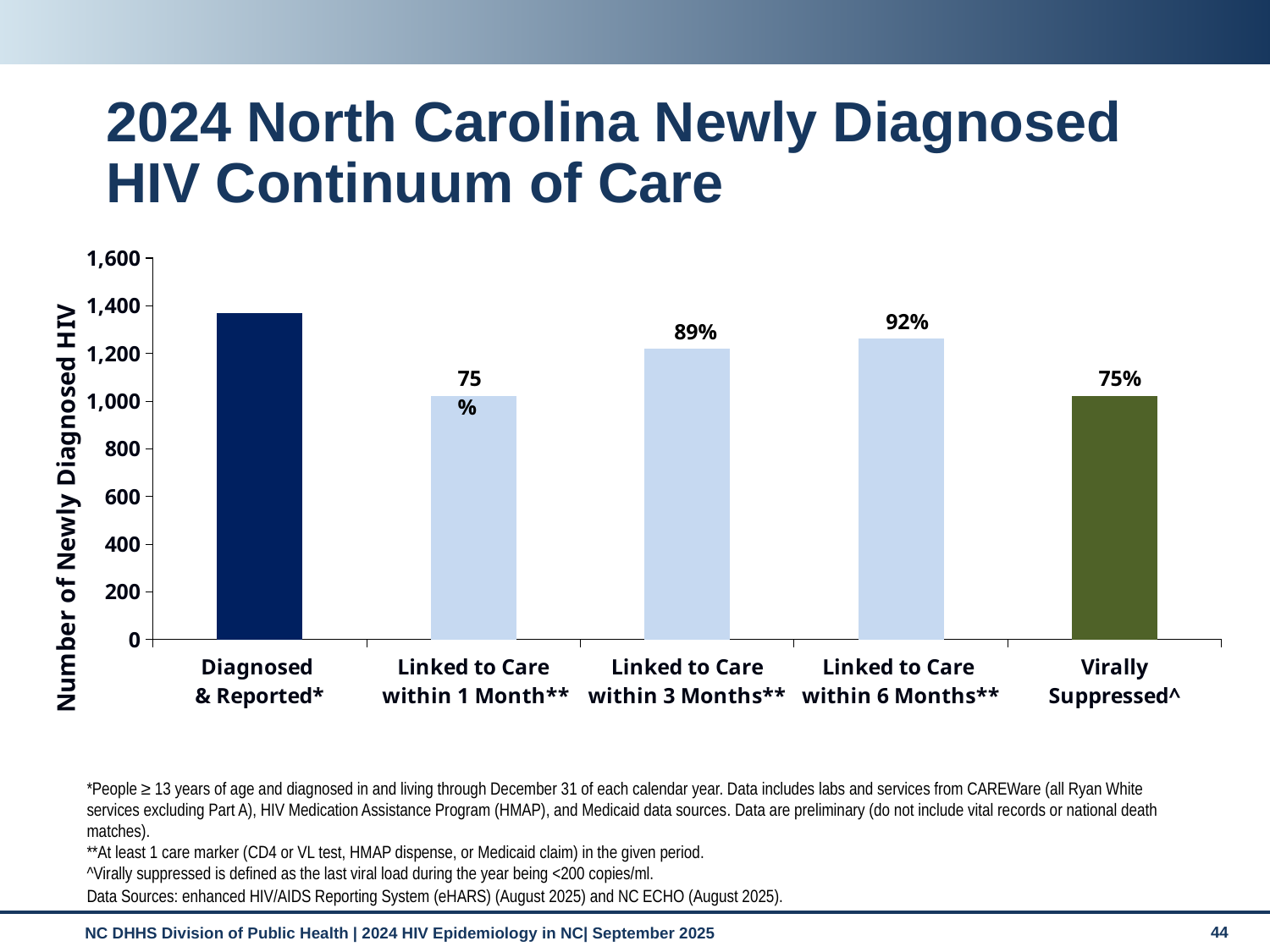
Is the value for Virally Suppressed^ greater or less than 1,200? less What percentage label is shown on the Linked to Care within 3 Months** bar? 89% What percentage label is shown on the Linked to Care within 1 Month** bar? 75% Which bar is taller: Diagnosed & Reported* or Virally Suppressed^? Diagnosed & Reported* What percentage label is shown on the Virally Suppressed^ bar? 75% What percentage label is shown on the Linked to Care within 6 Months** bar? 92% How many categories are shown on the x axis? 5 Which category has the tallest bar? Diagnosed & Reported* What is the title of the y axis? Number of Newly Diagnosed HIV What is the difference in percentage points between the labels on the Linked to Care within 6 Months** bar and the Linked to Care within 1 Month** bar? 17 percentage points What kind of chart is shown on the slide? Bar chart Is the value for Diagnosed & Reported* greater or less than 1,200? greater